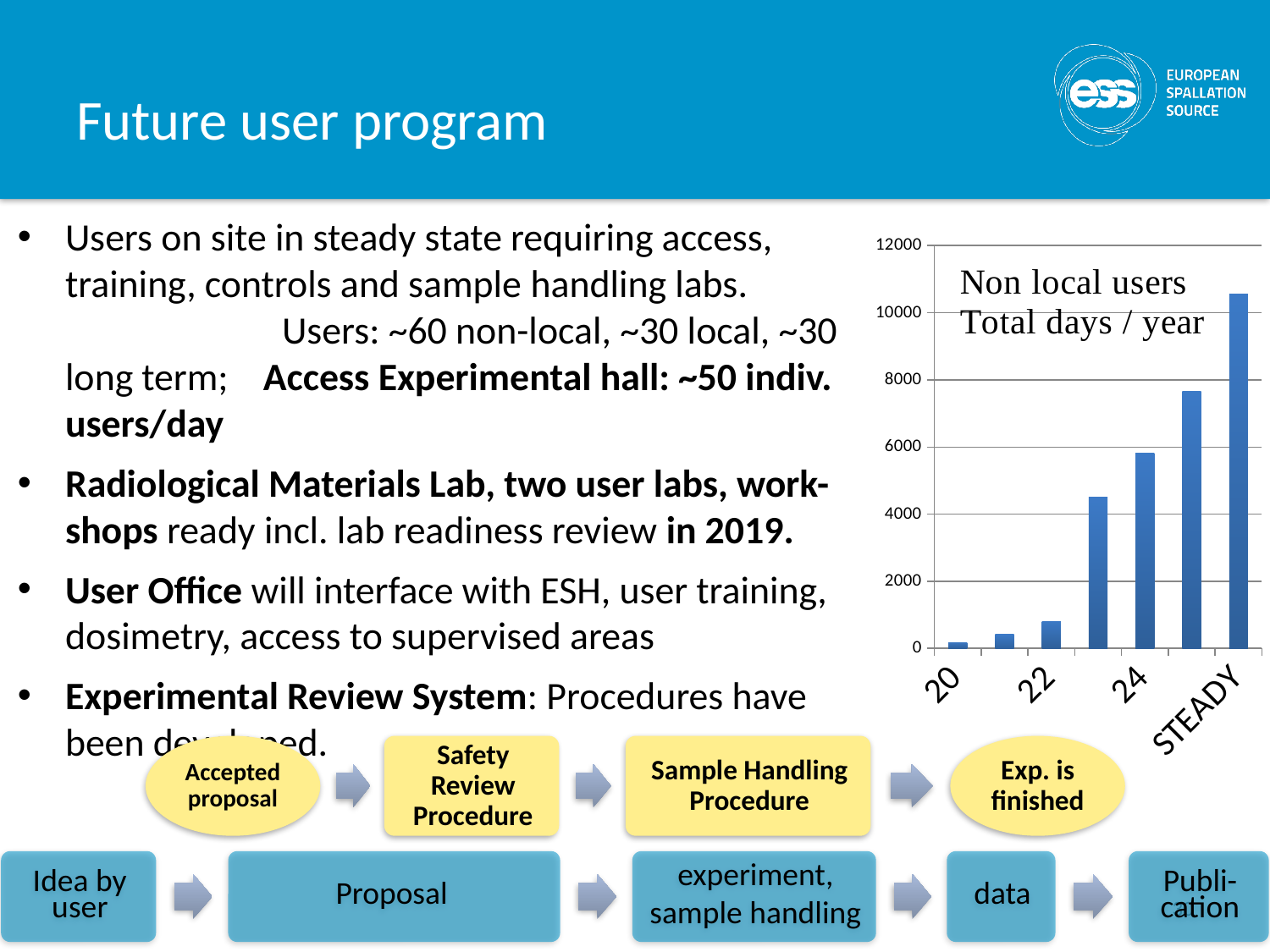
What kind of chart is shown on the slide? bar chart Is the value for 24 greater or less than 4000? greater Which category has the highest bar in the chart? STEADY Do the bar values rise or fall from left to right along the x axis? rise What text is written inside the chart area as its title? Non local users Total days / year Is the value for 20 greater or less than 2000? less How many bars are plotted in the chart? 7 What is the highest tick value shown on the chart's y axis? 12000 Which is larger, the value for 24 or the value for 22? 24 Is the value for STEADY greater or less than 10000? greater Which category has the lowest bar in the chart? 20